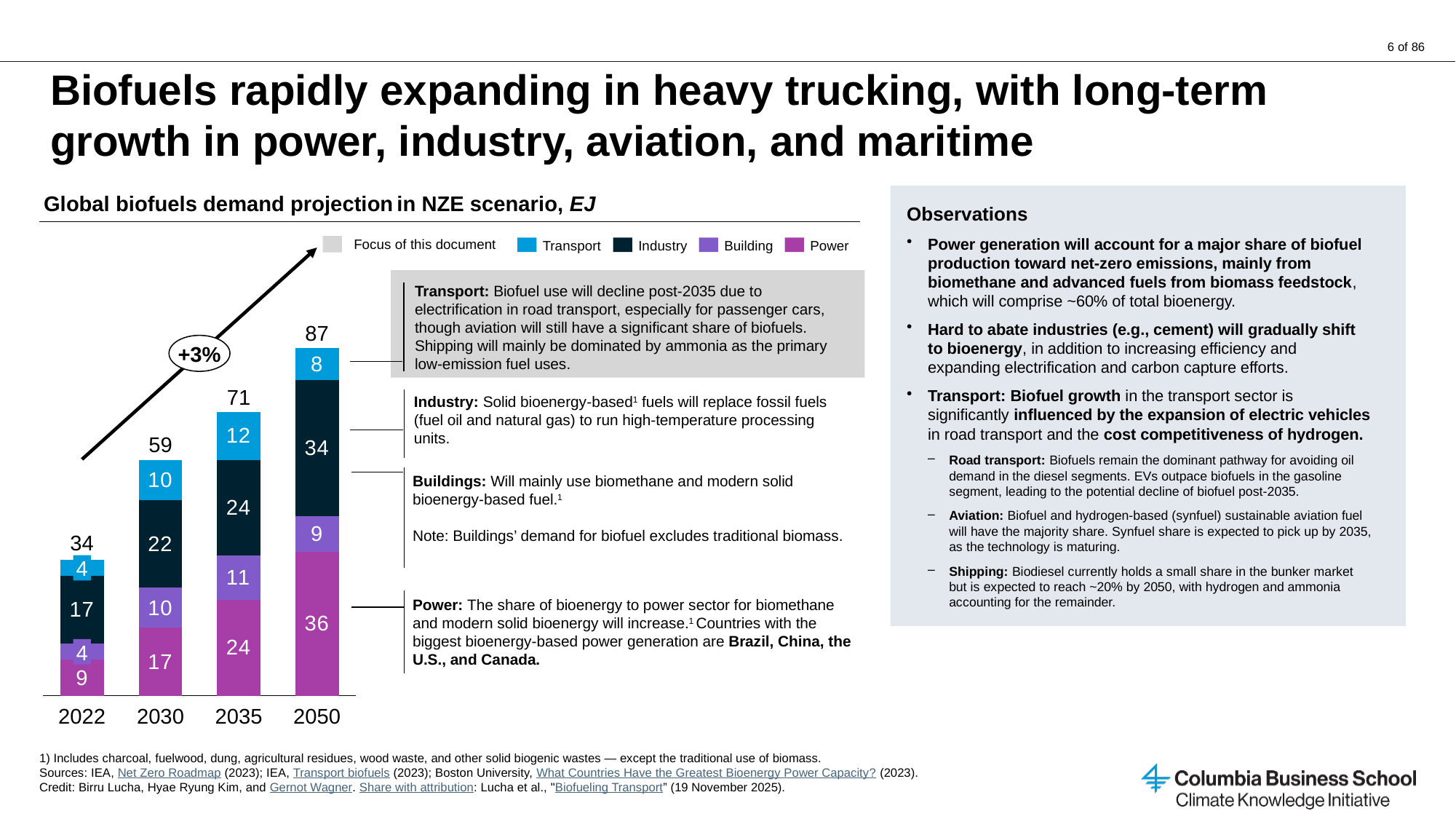
What is the difference between the Industry values for 2050 and 2022? 17 What is the Power value for 2050 in the global biofuels demand projection chart? 36 Which year has the lowest total global biofuels demand in the chart? 2022 What is the Industry value for 2030 in the global biofuels demand projection chart? 22 How many sectors (Transport, Industry, Building, Power) does the chart legend list? 4 What type of chart is used to show the global biofuels demand projection? Stacked bar chart Is the Power value larger in 2035 or in 2050? 2050 What is the total global biofuels demand shown for 2050? 87 Which year has the highest Transport value in the chart? 2035 What is the Transport value for 2035 in the global biofuels demand projection chart? 12 How many years are shown on the x axis of the global biofuels demand projection chart? 4 What annual growth rate is shown in the oval above the bars? +3%